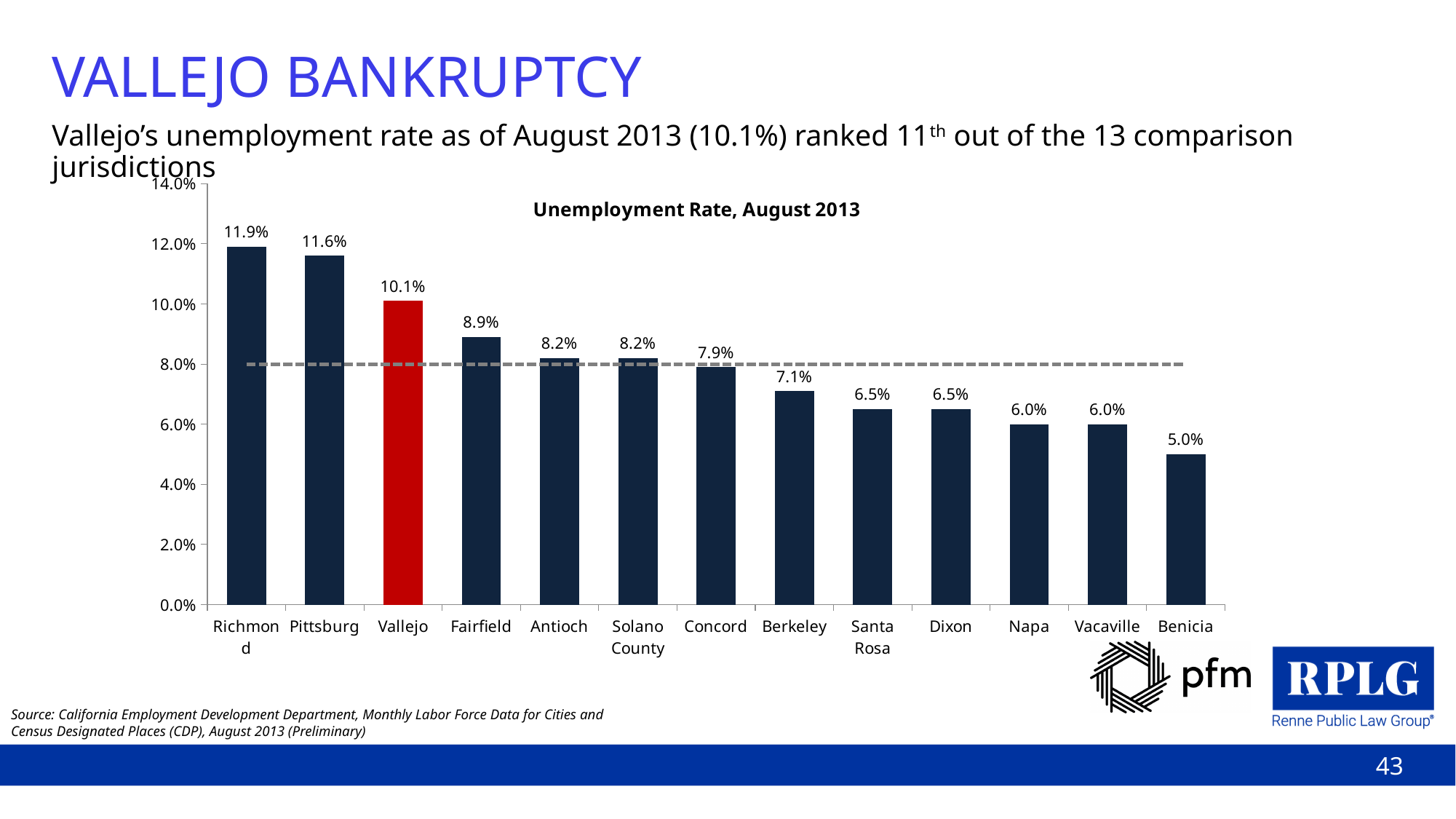
How many jurisdictions are shown in the chart? 13 What is the difference between the unemployment rates of Richmond and Vallejo? 1.8% What is the title of the chart? Unemployment Rate, August 2013 What is the difference between the unemployment rates of Pittsburg and Concord? 3.7% What is the unemployment rate shown for Vallejo? 10.1% What kind of chart is used to show the unemployment rates? Bar chart Which jurisdiction has the highest unemployment rate in the chart? Richmond Is the unemployment rate for Antioch greater or less than 8.0%? greater Which jurisdiction has the lowest unemployment rate in the chart? Benicia Which has a higher unemployment rate, Berkeley or Napa? Berkeley What is the unemployment rate shown for Benicia? 5.0% What is the unemployment rate shown for Fairfield? 8.9%